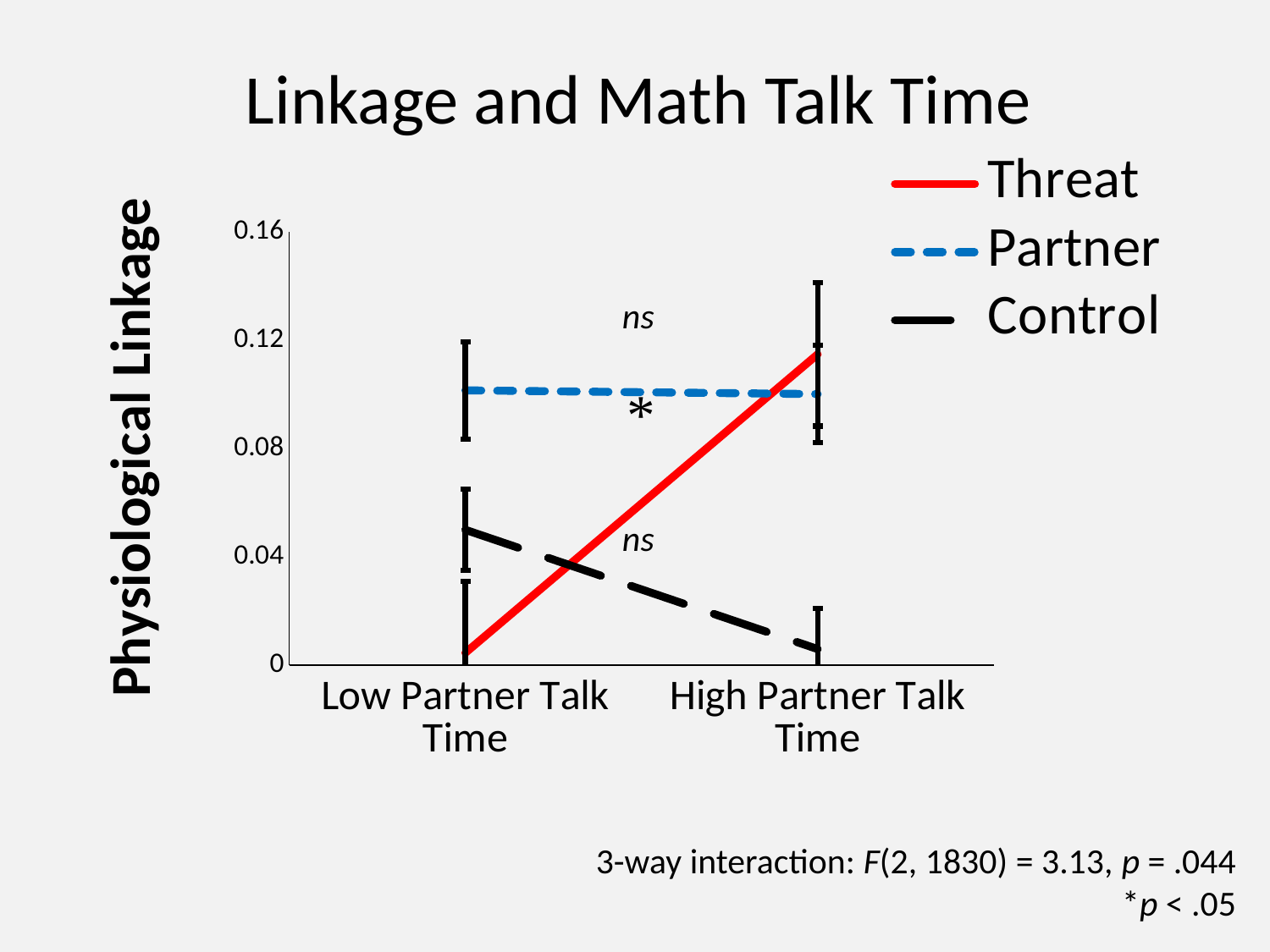
Is the value for Control at High Partner Talk Time greater or less than 0.04? less How many categories are on the x axis? 2 How many series does the legend list? 3 Is the value for Threat at Low Partner Talk Time greater or less than 0.04? less Is the value for Threat at High Partner Talk Time greater or less than 0.08? greater Does the Control series rise or fall from Low Partner Talk Time to High Partner Talk Time? fall What kind of chart is shown on the slide? line chart Which series has the highest value at High Partner Talk Time? Threat What is the label on the y axis? Physiological Linkage Does the Threat series rise or fall from Low Partner Talk Time to High Partner Talk Time? rise At Low Partner Talk Time, which is larger, Partner or Threat? Partner What is the title of the chart? Linkage and Math Talk Time